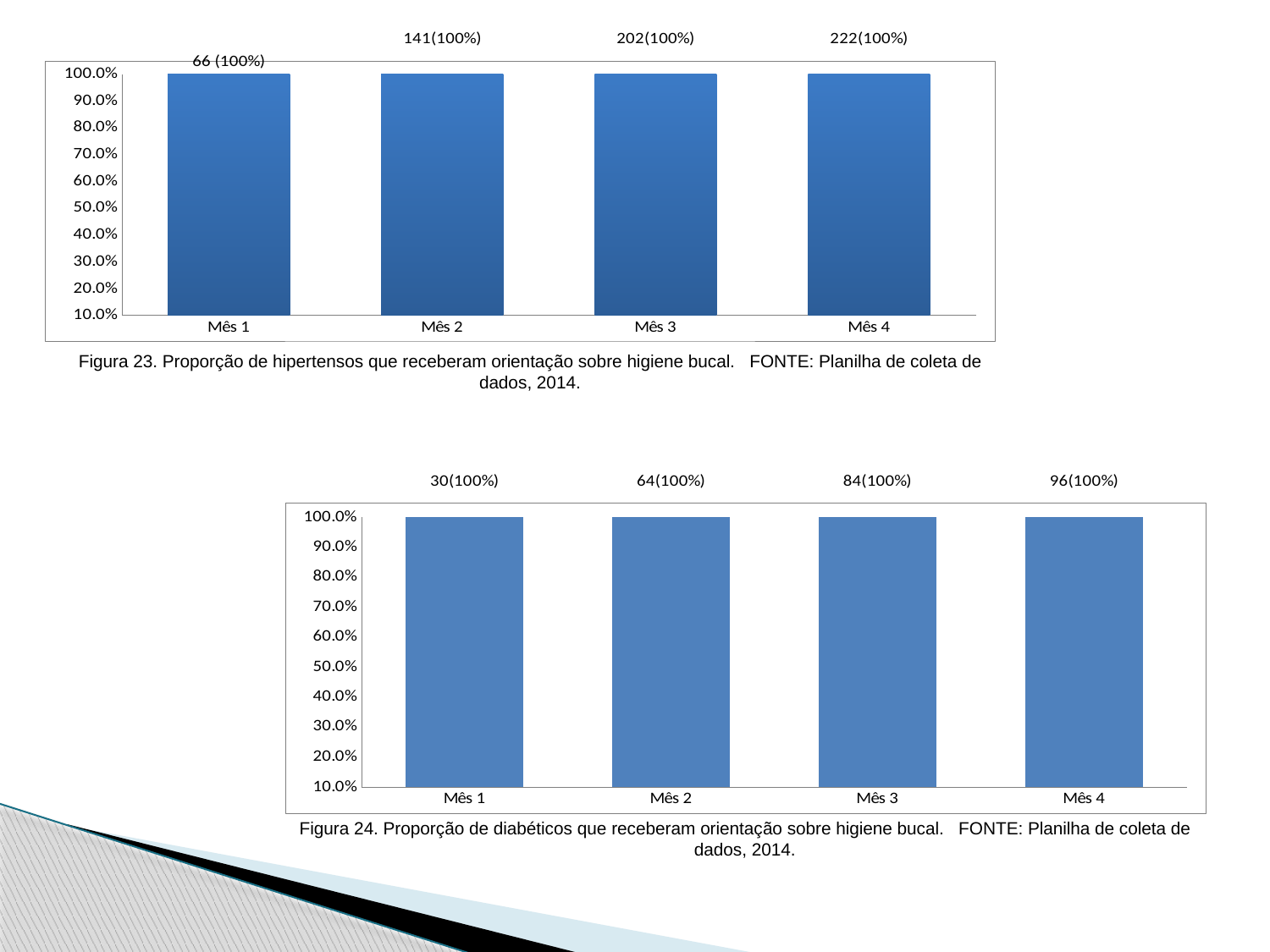
In the bottom chart (Figura 24), what is the data label shown above the bar for Mês 2? 64(100%) In the top chart (Figura 23), what is the data label shown above the bar for Mês 3? 202(100%) In the top chart (Figura 23), what is the data label shown above the bar for Mês 4? 222(100%) In the bottom chart (Figura 24), which month has the smallest number of diabetic patients in its data label? Mês 1 In the bottom chart (Figura 24), what is the data label shown above the bar for Mês 4? 96(100%) What is the caption title of the bottom chart? Figura 24. Proporção de diabéticos que receberam orientação sobre higiene bucal. In the top chart (Figura 23), which month has the largest number of hypertensive patients in its data label? Mês 4 In the top chart (Figura 23), how many months are shown on the x axis? 4 In the top chart (Figura 23), what is the data label shown above the bar for Mês 1? 66 (100%) What kind of chart is the top chart (Figura 23)? Bar chart In the bottom chart (Figura 24), what percentage do all four bars reach? 100.0% In the bottom chart (Figura 24), what is the data label shown above the bar for Mês 1? 30(100%)